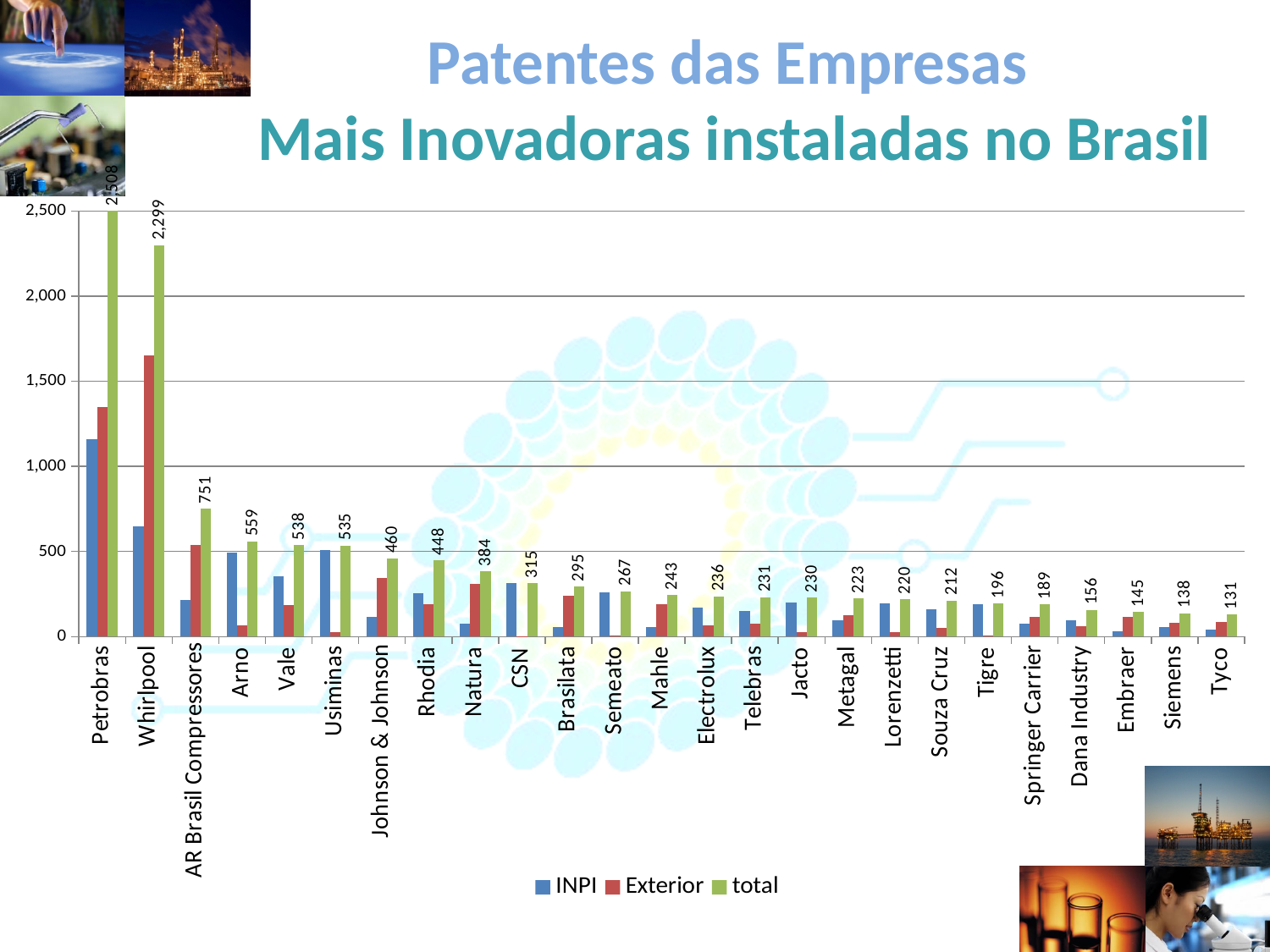
How many series does the legend list? 3 Which company has the highest total? Petrobras What is the difference between the total for Petrobras and the total for Whirlpool? 209 What kind of chart is shown on the slide? bar chart Is the Exterior value for Whirlpool greater or less than 1,500? greater Is the INPI value for Petrobras greater or less than 1,000? greater Which company has the lowest total? Tyco What is the total value shown for Petrobras? 2,508 What is the total value shown for Embraer? 145 How many companies are shown on the x axis? 25 What is the total value shown for Vale? 538 Which has the larger total, Arno or Vale? Arno